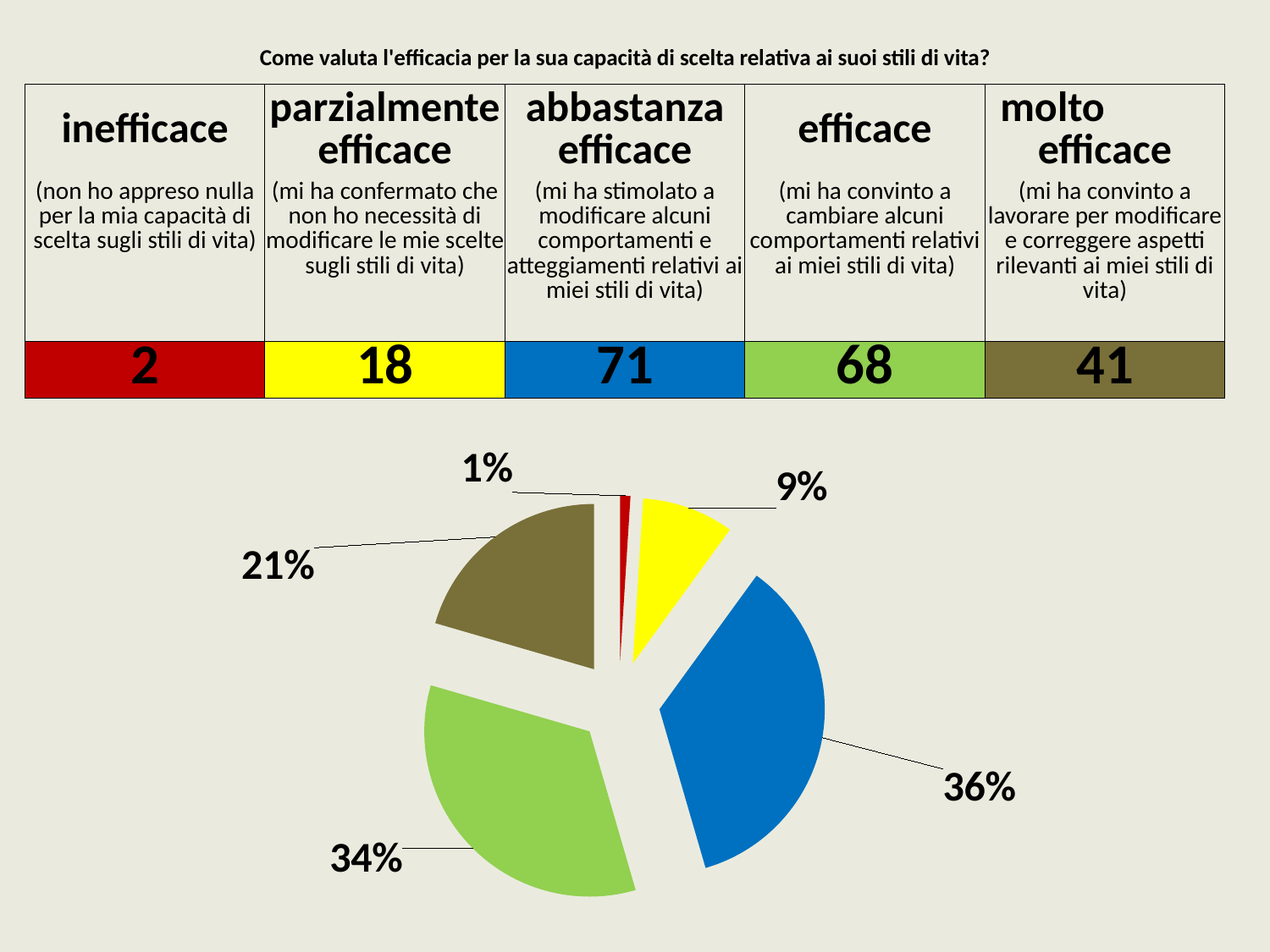
Which slice of the pie chart has the largest share? the blue slice (36%) How many slices does the pie chart have? 5 Which slice of the pie chart has the smallest share? the red slice (1%) According to the table above the pie chart, how many respondents answered 'abbastanza efficace'? 71 What kind of chart is shown on the slide? pie chart Which is larger in the pie chart, the blue slice or the green slice? the blue slice What percentage is shown for the green slice of the pie chart? 34% What is the difference in percentage points between the blue slice (36%) and the olive-brown slice (21%) of the pie chart? 15 What percentage is shown for the red slice of the pie chart? 1% What percentage is shown for the olive-brown slice of the pie chart? 21%